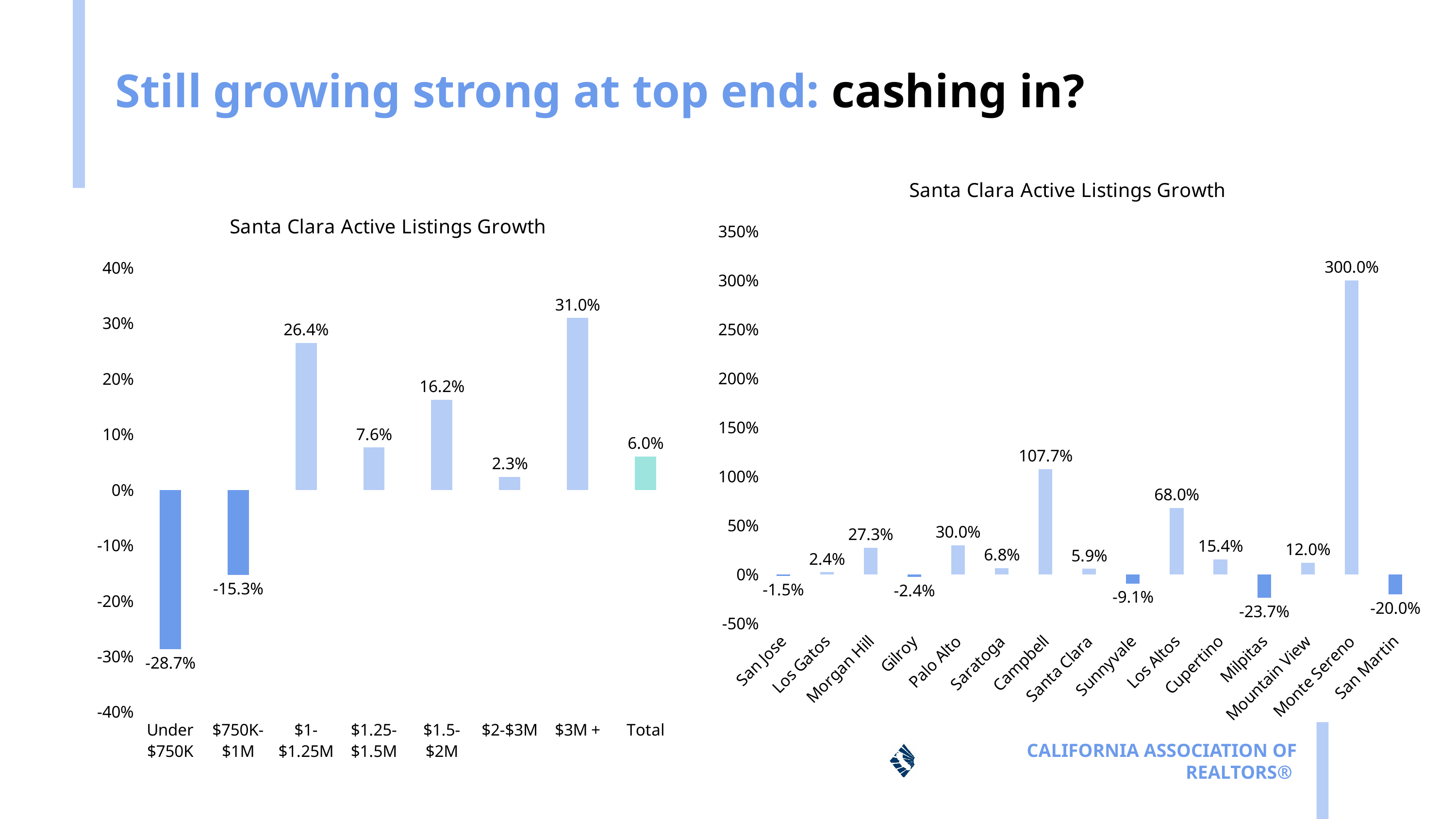
In the left chart, which price range has the lowest active listings growth? Under $750K In the left chart, how many price-range categories (including Total) are shown? 8 In the right chart, what is the active listings growth for Campbell? 107.7% In the right chart, how many cities are shown on the x axis? 15 In the left chart, which price range has the highest active listings growth? $3M + In the left chart, what is the difference between the growth for $1-$1.25M and the growth for $1.25-$1.5M? 18.8% What type of chart is the right chart? bar chart In the left chart, what is the active listings growth for the $3M + price range? 31.0% In the right chart, which city has the lowest active listings growth? Milpitas In the right chart, which city has the highest active listings growth? Monte Sereno In the right chart, is the growth for Los Altos larger or smaller than the growth for Palo Alto? larger In the left chart, what is the value shown for Total? 6.0%